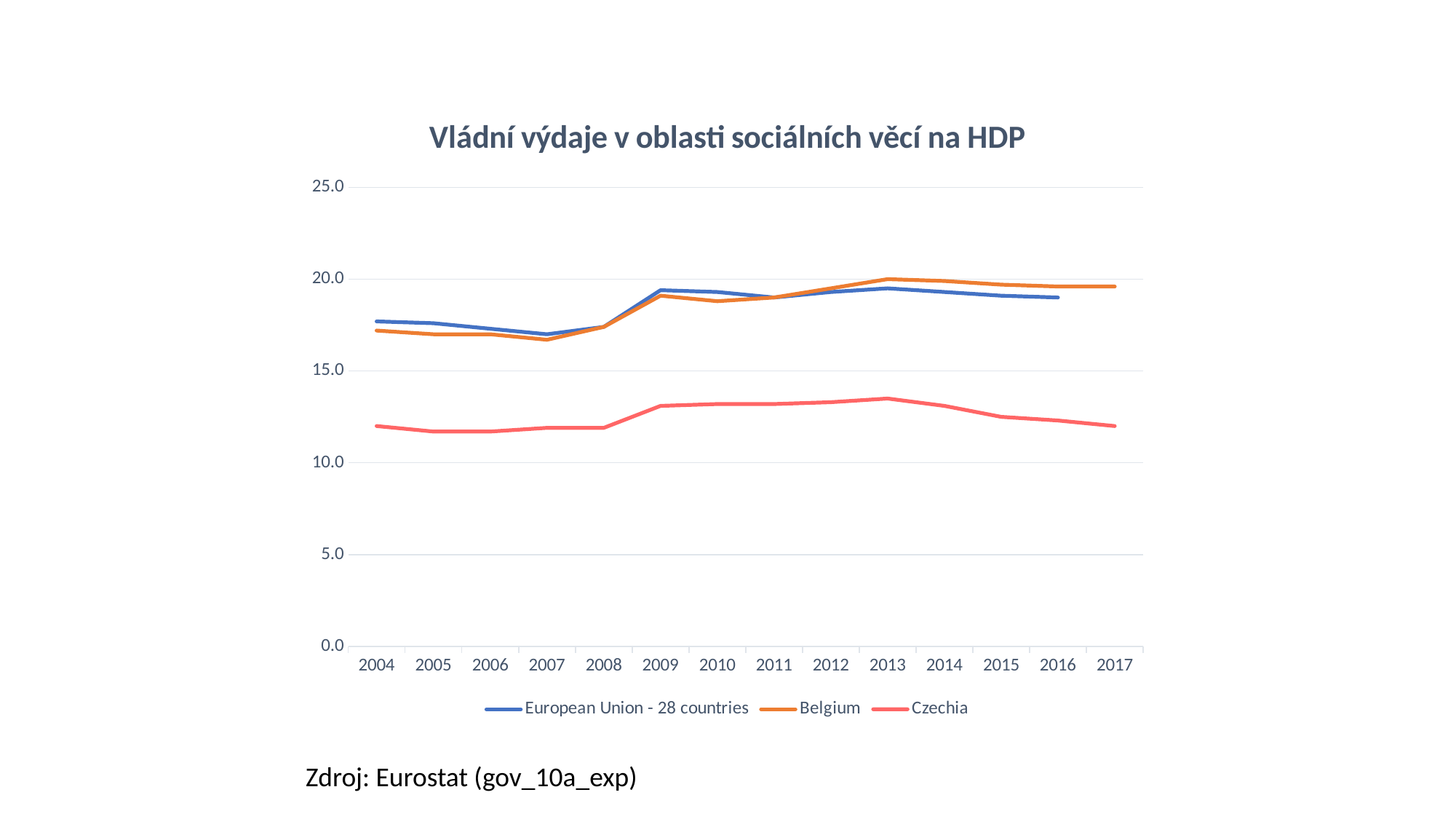
How many series does the legend list? 3 What kind of chart is shown on the slide? line chart Is the value for European Union - 28 countries in 2004 greater or less than 20.0? less Which series is drawn in red? Czechia Is the value for Belgium in 2007 greater or less than 15.0? greater In which year does Czechia reach its highest value? 2013 Is the value for Czechia in 2013 greater or less than 15.0? less For Belgium, which is larger: the value in 2007 or the value in 2013? 2013 How many years are plotted along the x axis? 14 What is the title of the chart? Vládní výdaje v oblasti sociálních věcí na HDP Does the value for Czechia rise or fall from 2013 to 2017? fall In 2010, which is larger: the value for Belgium or the value for Czechia? Belgium